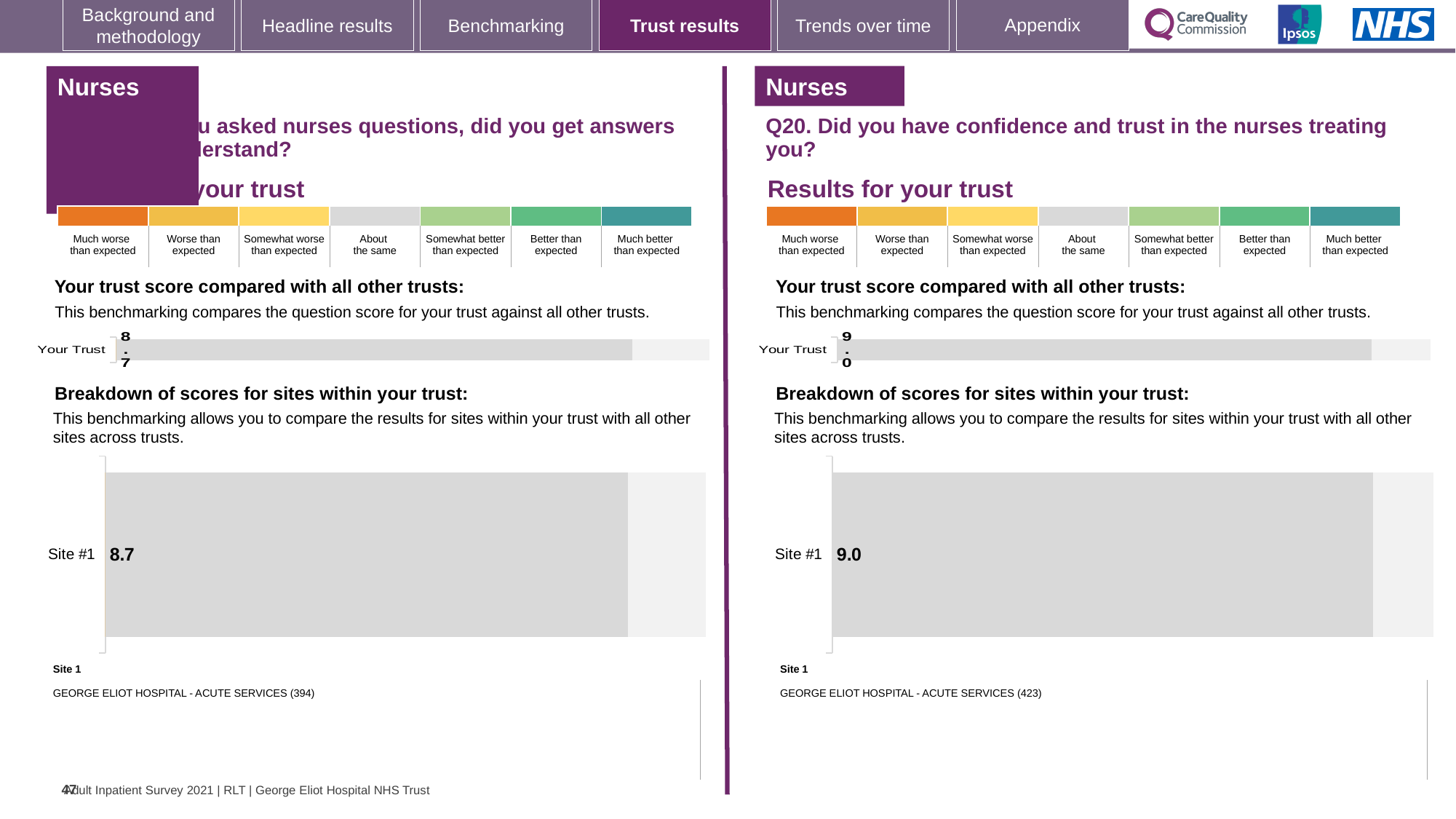
What type of chart is used to show the Site #1 score in the right (Q20) breakdown section? Bar chart What is the name of the site labelled Site 1 on the left half of the slide? GEORGE ELIOT HOSPITAL - ACUTE SERVICES (394) Which is larger: the Site #1 score in the left breakdown chart or the Site #1 score in the right (Q20) breakdown chart? The right (Q20) chart What is the difference between the Site #1 score in the right (Q20) breakdown chart and the Site #1 score in the left breakdown chart? 0.3 In the right (Q20) 'Breakdown of scores for sites within your trust' chart, what is the score for Site #1? 9.0 On the left half of the slide, what is the score shown for Your Trust in the 'Your trust score compared with all other trusts' chart? 8.7 In the left 'Breakdown of scores for sites within your trust' chart, what is the score for Site #1? 8.7 How many sites are shown in the left 'Breakdown of scores for sites within your trust' chart? 1 On the right half of the slide (Q20), what is the score shown for Your Trust in the 'Your trust score compared with all other trusts' chart? 9.0 How many sites are shown in the right (Q20) 'Breakdown of scores for sites within your trust' chart? 1 What is the name of the site labelled Site 1 on the right (Q20) half of the slide? GEORGE ELIOT HOSPITAL - ACUTE SERVICES (423)